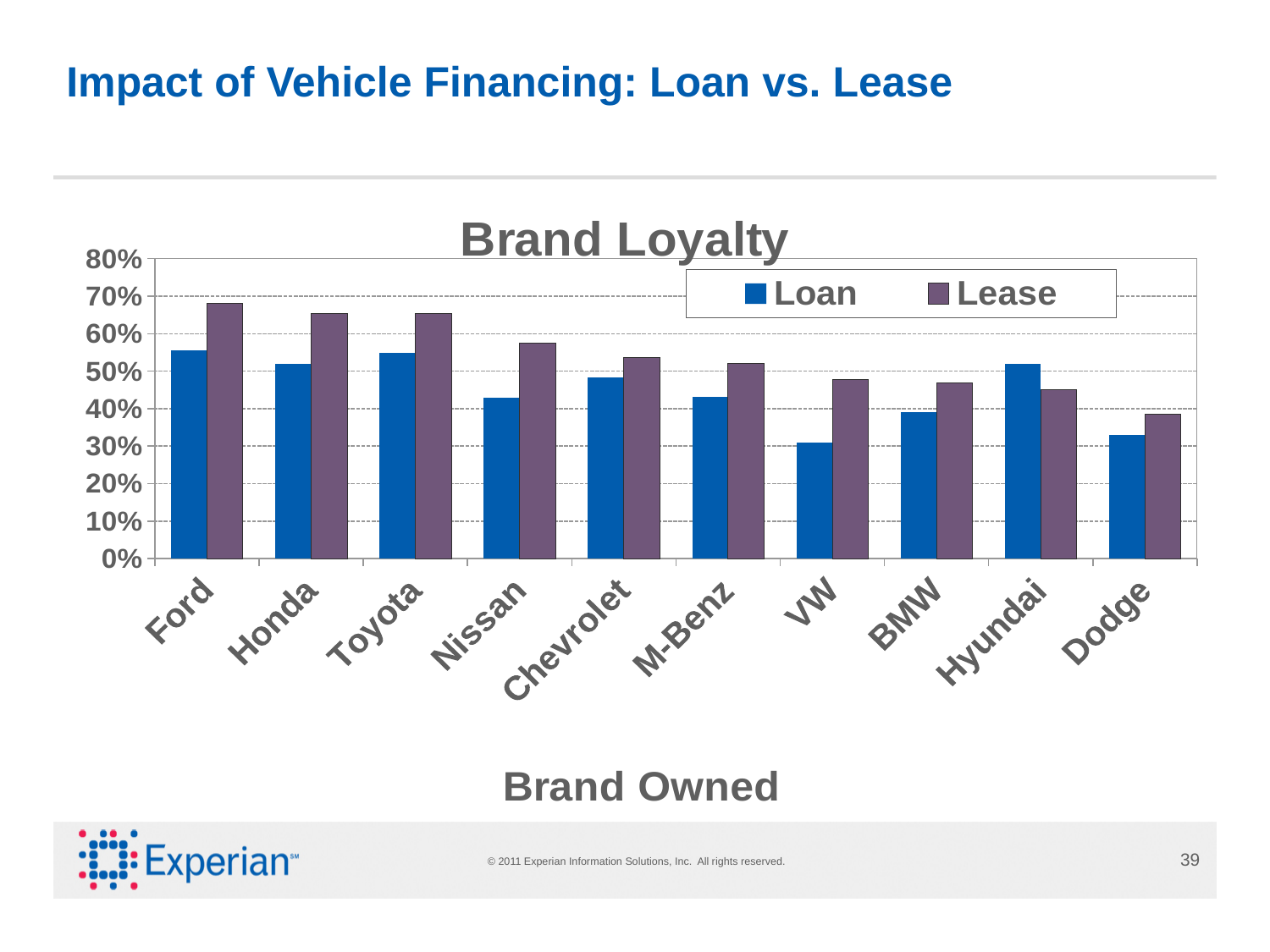
What is the title of the chart? Brand Loyalty Is the Lease value for Ford greater or less than 60%? greater For VW, which is larger, the Loan value or the Lease value? Lease Which brand has the lowest Lease value? Dodge How many series does the legend list? 2 How many brands are shown on the x axis? 10 What kind of chart is shown on the slide? Bar chart Which brand has the highest Lease value? Ford Is the Lease value for Nissan greater or less than 50%? greater Is the Loan value for VW greater or less than 40%? less For Hyundai, which is larger, the Loan value or the Lease value? Loan